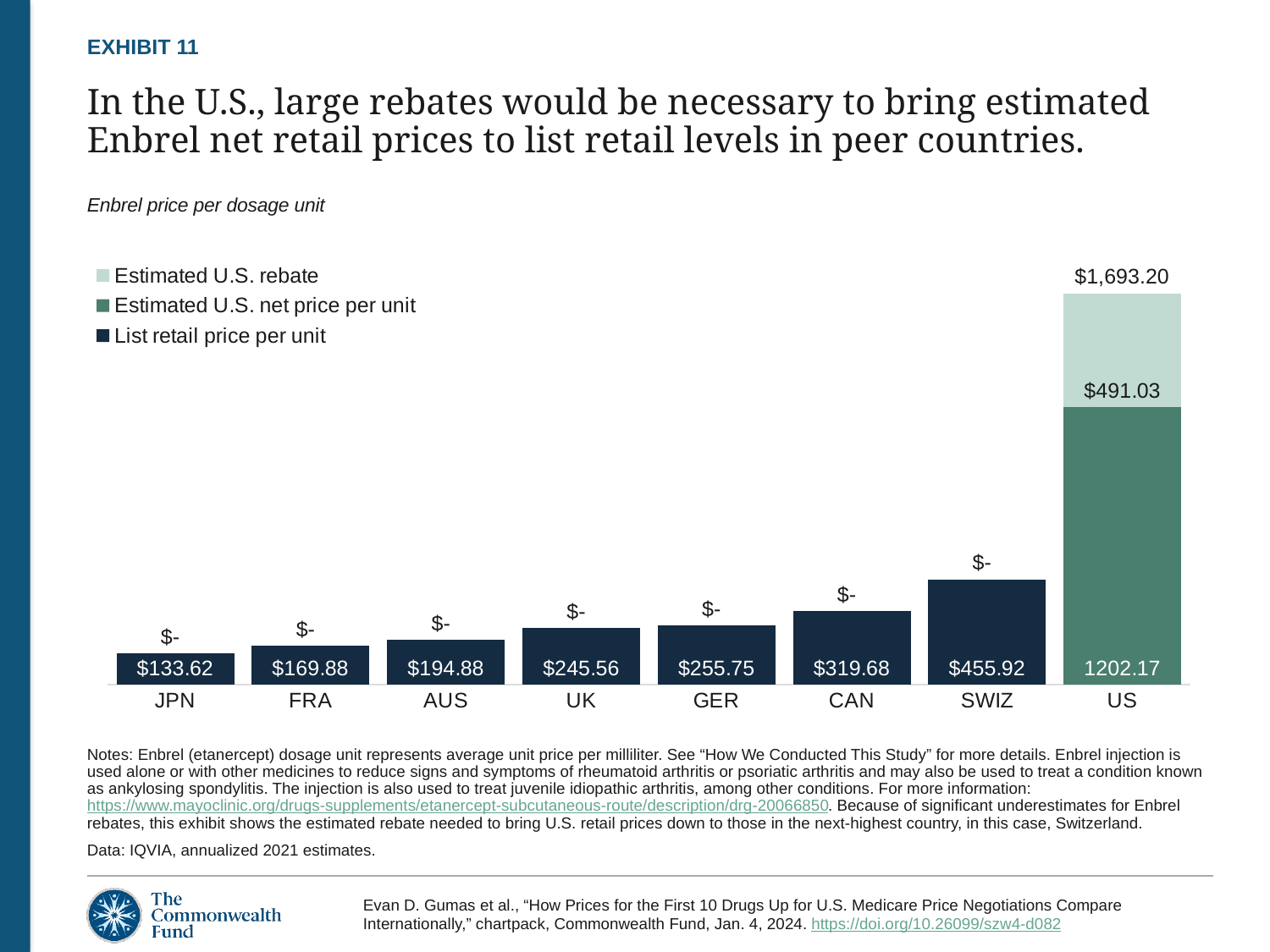
Which country has the lowest list retail price per unit? JPN Which country has the highest list retail price per unit? SWIZ What is the estimated U.S. net price per unit shown for the US bar? 1202.17 What is the list retail price per unit for JPN? $133.62 What is the list retail price per unit for CAN? $319.68 What is the list retail price per unit for SWIZ? $455.92 Do the list retail prices per unit rise or fall from JPN to US along the x axis? Rise How many countries are shown on the x axis? 8 Which has a higher list retail price per unit, UK or GER? GER What is the difference between the list retail price per unit for SWIZ and for CAN? $136.24 How many series does the legend list? 3 What kind of chart is shown on the slide? Stacked bar chart